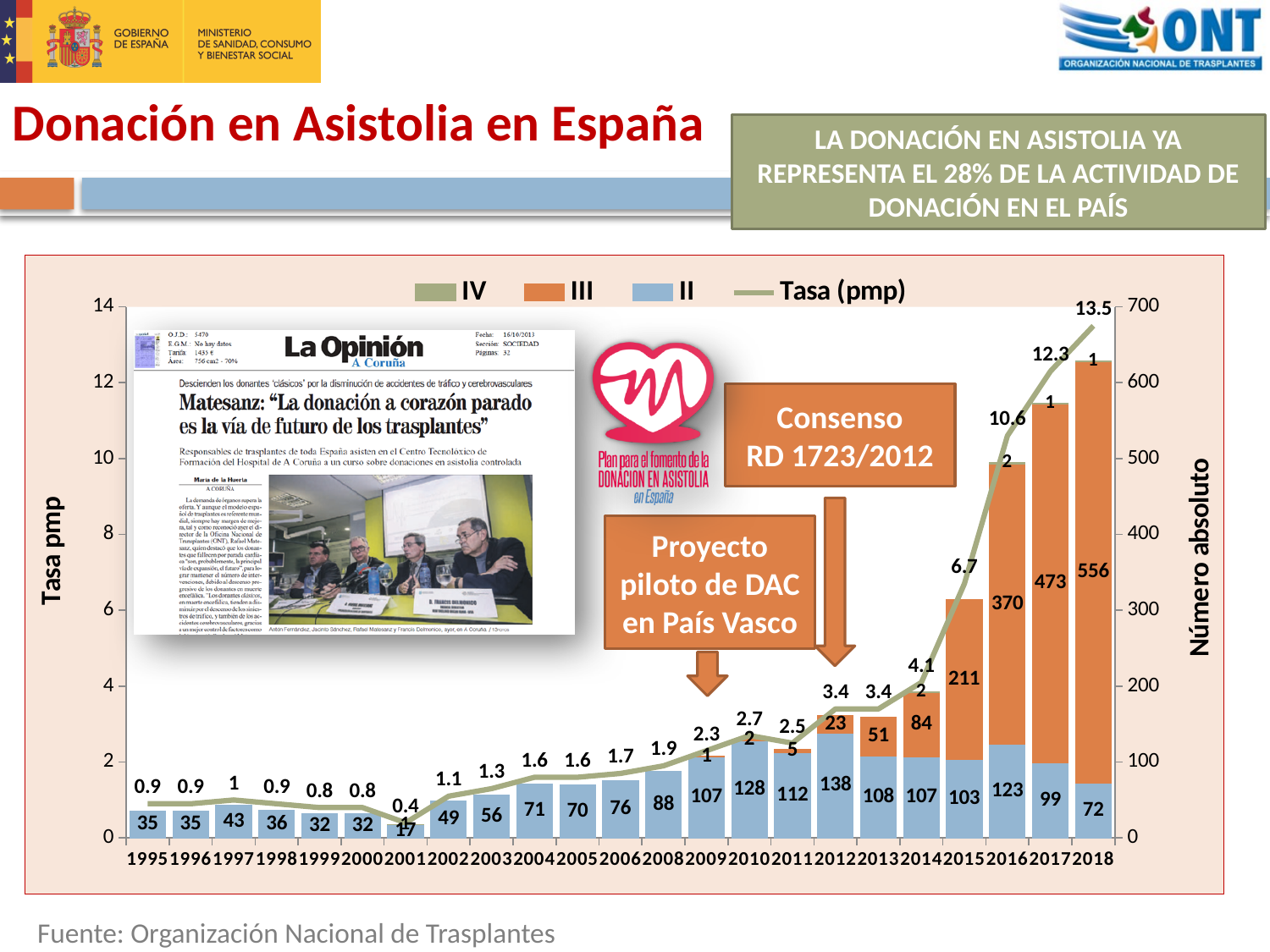
What is the value of series III for 2018? 556 In which year is the Tasa (pmp) line lowest? 2001 In which year is the Tasa (pmp) line highest? 2018 What kind of chart is shown? Combined stacked bar and line chart What is the Tasa (pmp) value for 2018? 13.5 Does the Tasa (pmp) line rise or fall from 2013 to 2018? Rise How many years are shown on the x axis? 23 What is the value of series II for 2012? 138 How many series does the legend list? 4 Which year has the larger value for series II, 2010 or 2011? 2010 By how much did the Tasa (pmp) increase from 2017 to 2018? 1.2 What is the total of the stacked bar for 2018 (series II, III and IV)? 629